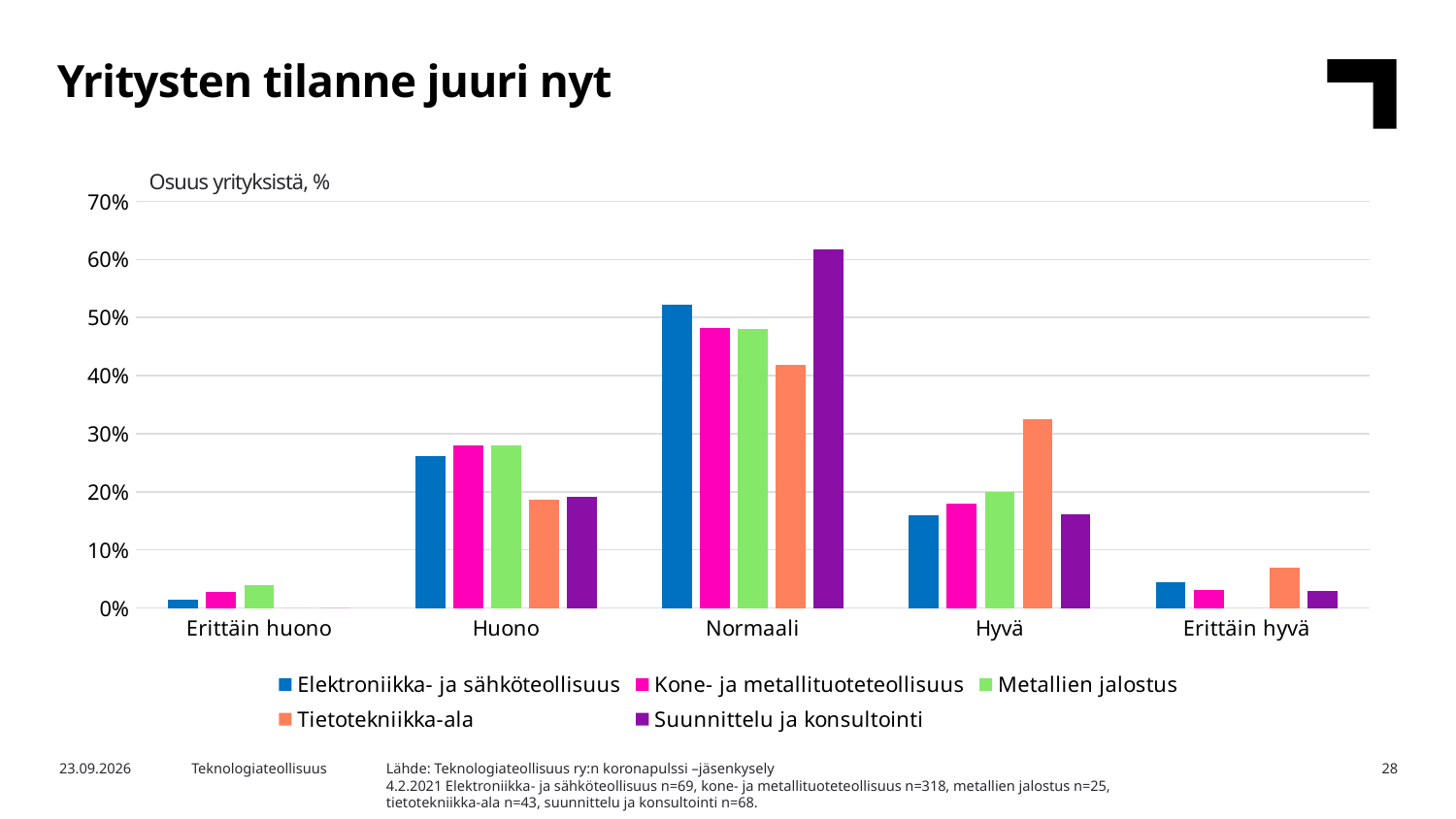
What is the label shown above the y axis of the chart? Osuus yrityksistä, % Which category on the x axis contains the tallest bars overall? Normaali Is the value for Tietotekniikka-ala in the 'Hyvä' category greater or less than 30%? greater How many series does the legend list? 5 In the 'Hyvä' category, which series has the highest bar? Tietotekniikka-ala Is the value for Elektroniikka- ja sähköteollisuus in the 'Normaali' category greater or less than 50%? greater In the 'Normaali' category, which series has the highest bar? Suunnittelu ja konsultointi What kind of chart is shown on the slide? Bar chart Is the value for Suunnittelu ja konsultointi in the 'Normaali' category greater or less than 60%? greater In the 'Huono' category, which is larger: Elektroniikka- ja sähköteollisuus or Tietotekniikka-ala? Elektroniikka- ja sähköteollisuus In the 'Normaali' category, which is larger: Tietotekniikka-ala or Suunnittelu ja konsultointi? Suunnittelu ja konsultointi How many categories are shown on the x axis of the chart? 5